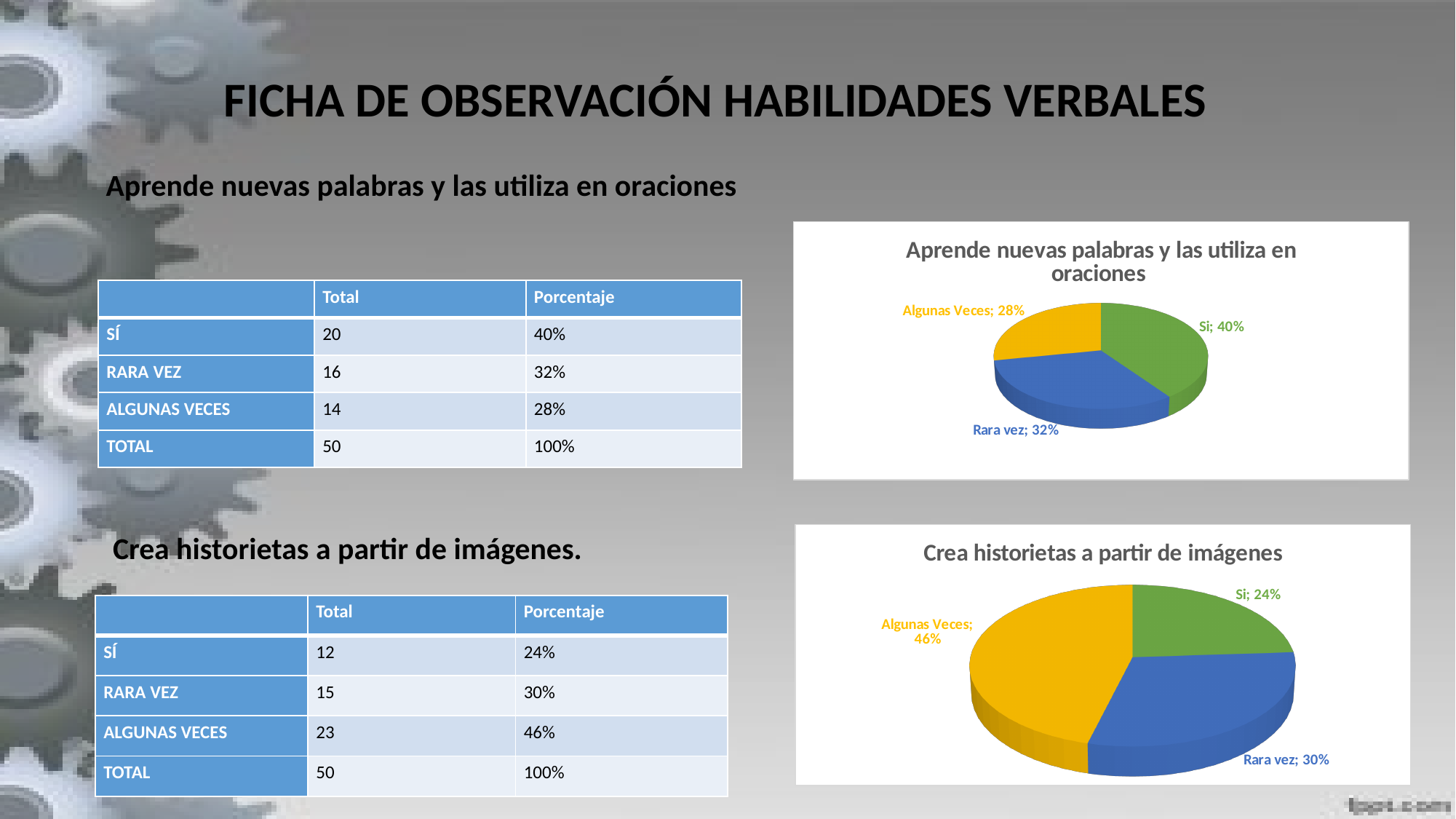
What type of chart is the chart titled 'Aprende nuevas palabras y las utiliza en oraciones'? Pie chart In the chart titled 'Aprende nuevas palabras y las utiliza en oraciones', what percentage is shown for 'Algunas Veces'? 28% In the chart titled 'Aprende nuevas palabras y las utiliza en oraciones', which category has the smallest share? Algunas Veces How many slices does the chart titled 'Crea historietas a partir de imágenes' have? 3 In the chart titled 'Crea historietas a partir de imágenes', which category has the smallest share? Si In the chart titled 'Crea historietas a partir de imágenes', which is larger: 'Rara vez' or 'Si'? Rara vez In the chart titled 'Crea historietas a partir de imágenes', what percentage is shown for 'Algunas Veces'? 46% In the chart titled 'Aprende nuevas palabras y las utiliza en oraciones', which category has the largest share? Si In the chart titled 'Aprende nuevas palabras y las utiliza en oraciones', what percentage is shown for 'Si'? 40% In the chart titled 'Crea historietas a partir de imágenes', what percentage is shown for 'Rara vez'? 30% In the chart titled 'Crea historietas a partir de imágenes', which category has the largest share? Algunas Veces In the chart titled 'Aprende nuevas palabras y las utiliza en oraciones', what is the difference in percentage points between 'Si' and 'Rara vez'? 8